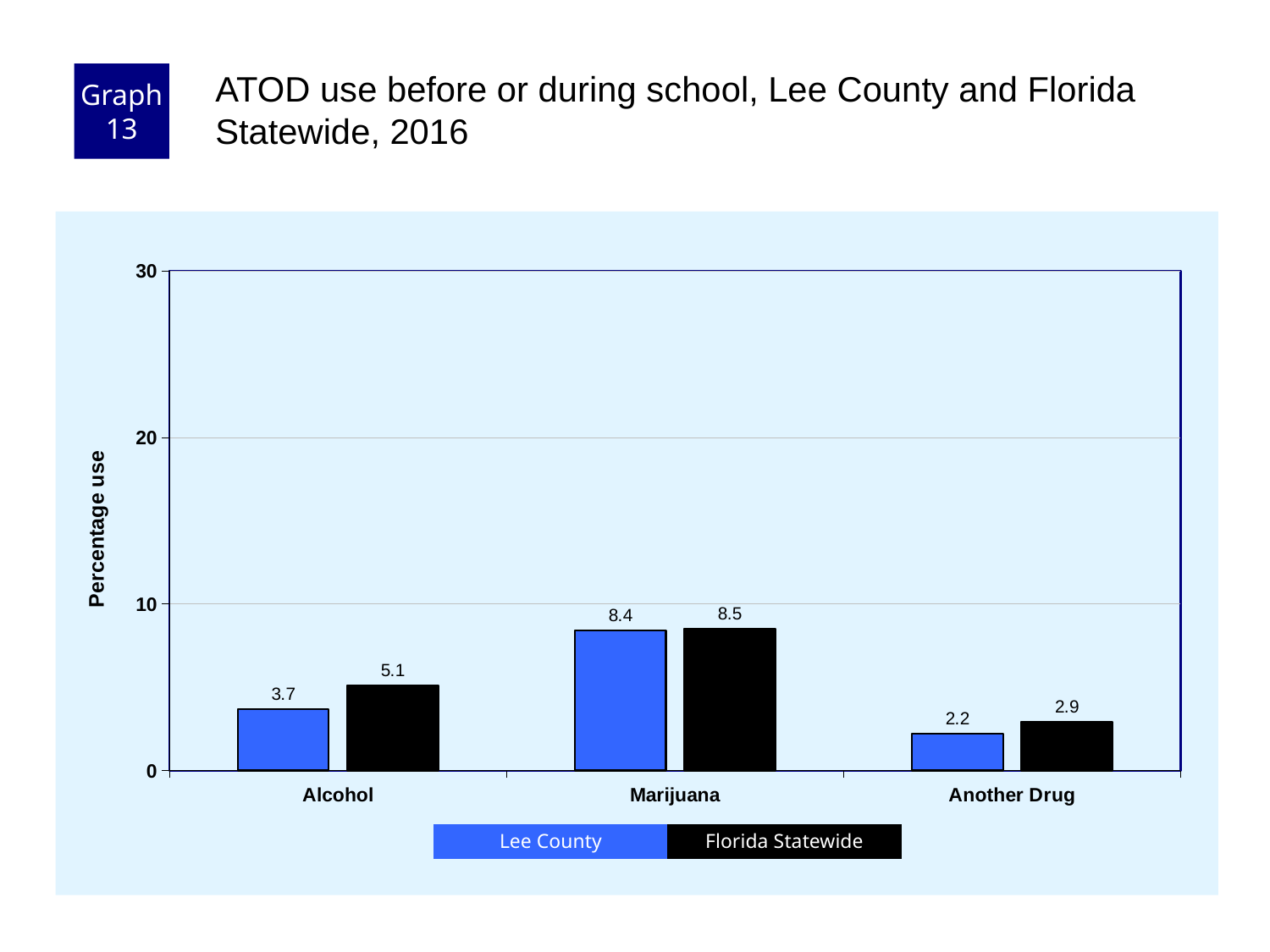
Which category has the lowest Florida Statewide value? Another Drug What is the Lee County value for Alcohol? 3.7 Is the Florida Statewide value for Marijuana greater or less than 10? less What is the difference between the Florida Statewide and Lee County values for Alcohol? 1.4 What is the Florida Statewide value for Marijuana? 8.5 What is the Florida Statewide value for Alcohol? 5.1 What kind of chart is shown? bar chart Which category has the highest Lee County value? Marijuana What is the Lee County value for Another Drug? 2.2 Which is larger for Another Drug, Lee County or Florida Statewide? Florida Statewide How many series does the legend list? 2 How many categories are shown on the x axis? 3